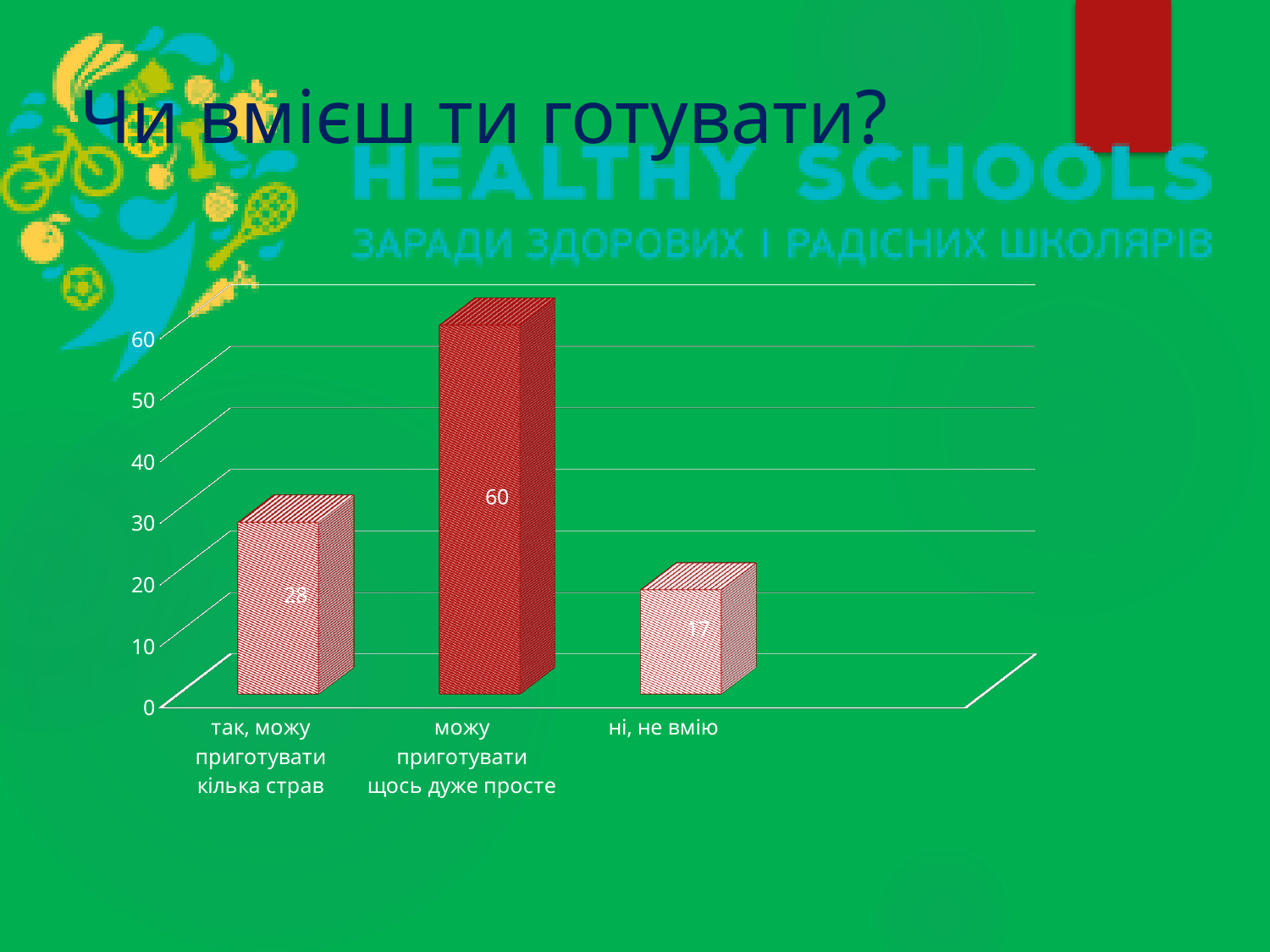
Is the value for "ні, не вмію" greater or less than 20? less What is the difference between the values for "так, можу приготувати кілька страв" and "ні, не вмію"? 11 Which is larger: the value for "так, можу приготувати кілька страв" or the value for "ні, не вмію"? так, можу приготувати кілька страв Which category has the highest value? можу приготувати щось дуже просте What is the value for "так, можу приготувати кілька страв"? 28 What is the value for "ні, не вмію"? 17 What is the value for "можу приготувати щось дуже просте"? 60 What kind of chart is shown on the slide? bar chart How many categories are shown on the chart? 3 What is the title of the slide containing the chart? Чи вмієш ти готувати? Which category has the lowest value? ні, не вмію What is the difference between the values for "можу приготувати щось дуже просте" and "так, можу приготувати кілька страв"? 32